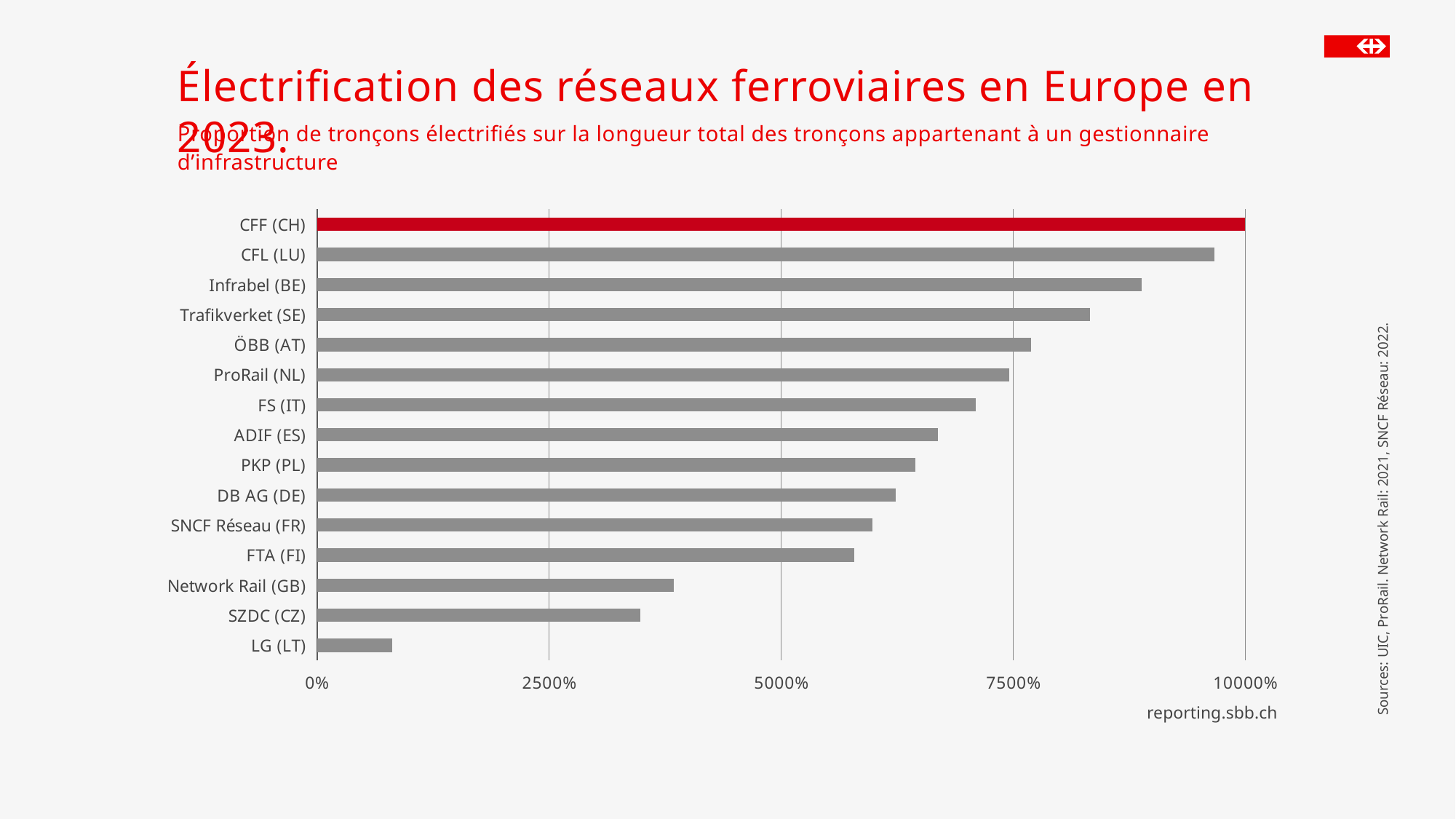
Is the value for Network Rail (GB) greater or less than 5000%? less Which infrastructure manager has the highest value in the chart? CFF (CH) Which has the larger value, Infrabel (BE) or ÖBB (AT)? Infrabel (BE) Is the value for SZDC (CZ) greater or less than 2500%? greater Which infrastructure manager has the lowest value in the chart? LG (LT) What kind of chart is shown on the slide? bar chart Is the value for ÖBB (AT) greater or less than 7500%? greater How many infrastructure managers (categories) are plotted in the chart? 15 Which bar in the chart is coloured red rather than grey? CFF (CH)